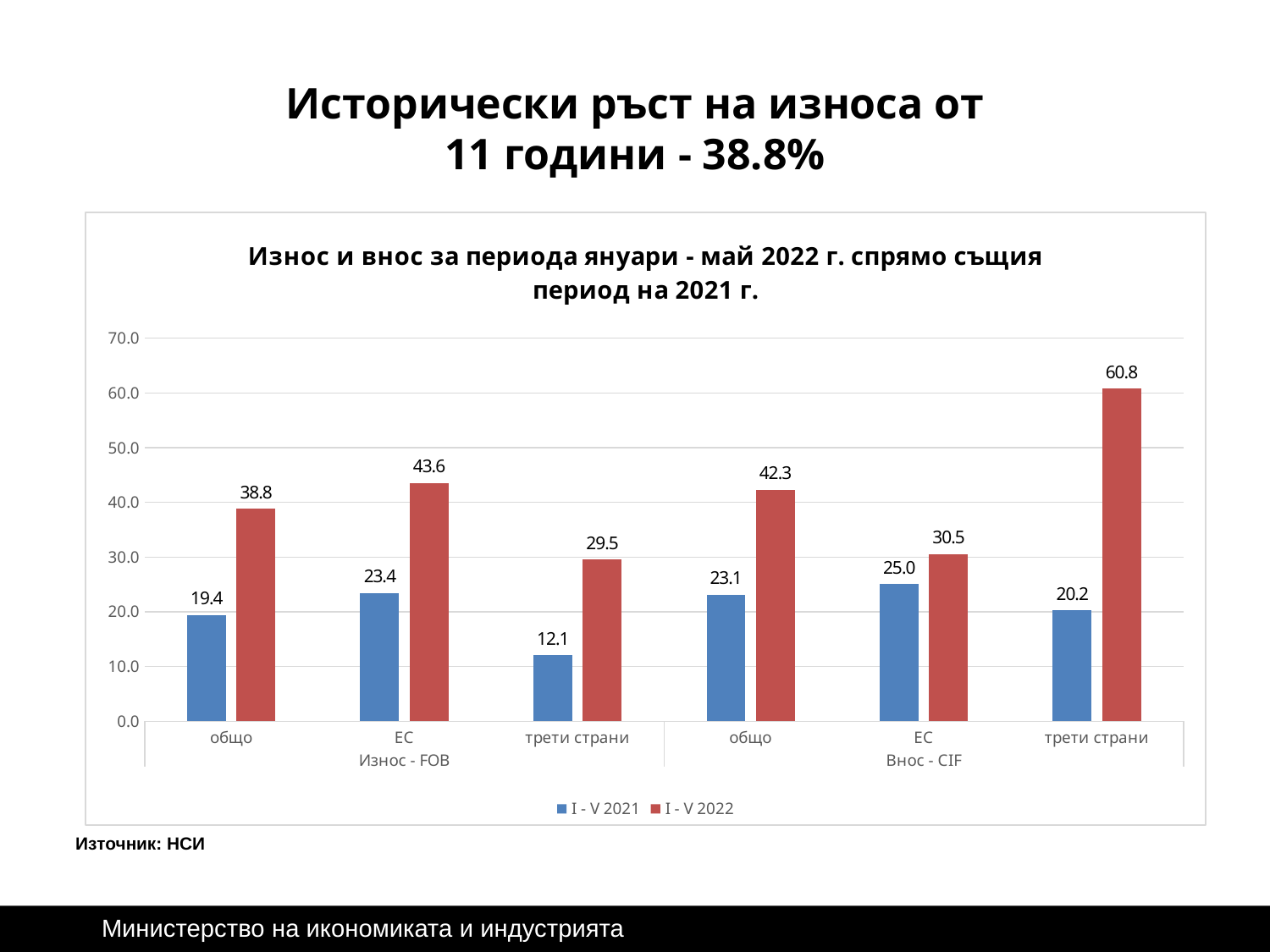
Which category has the highest I - V 2022 value? трети страни (Внос - CIF) Which category has the lowest I - V 2021 value? трети страни (Износ - FOB) What kind of chart is shown on the slide? bar chart What is the difference between the I - V 2022 and I - V 2021 values for "ЕС" under "Внос - CIF"? 5.5 What is the value for I - V 2022 for "общо" under "Износ - FOB"? 38.8 What is the value for I - V 2021 for "ЕС" under "Износ - FOB"? 23.4 How many series does the legend list? 2 What is the title of the chart? Износ и внос за периода януари - май 2022 г. спрямо същия период на 2021 г. How many categories are shown on the x axis? 6 Which is larger: the I - V 2022 value for "ЕС" under "Износ - FOB" or the I - V 2022 value for "общо" under "Внос - CIF"? ЕС under Износ - FOB (43.6) Is the I - V 2022 value for "трети страни" under "Внос - CIF" greater or less than 60.0? greater What is the value for I - V 2021 for "трети страни" under "Внос - CIF"? 20.2